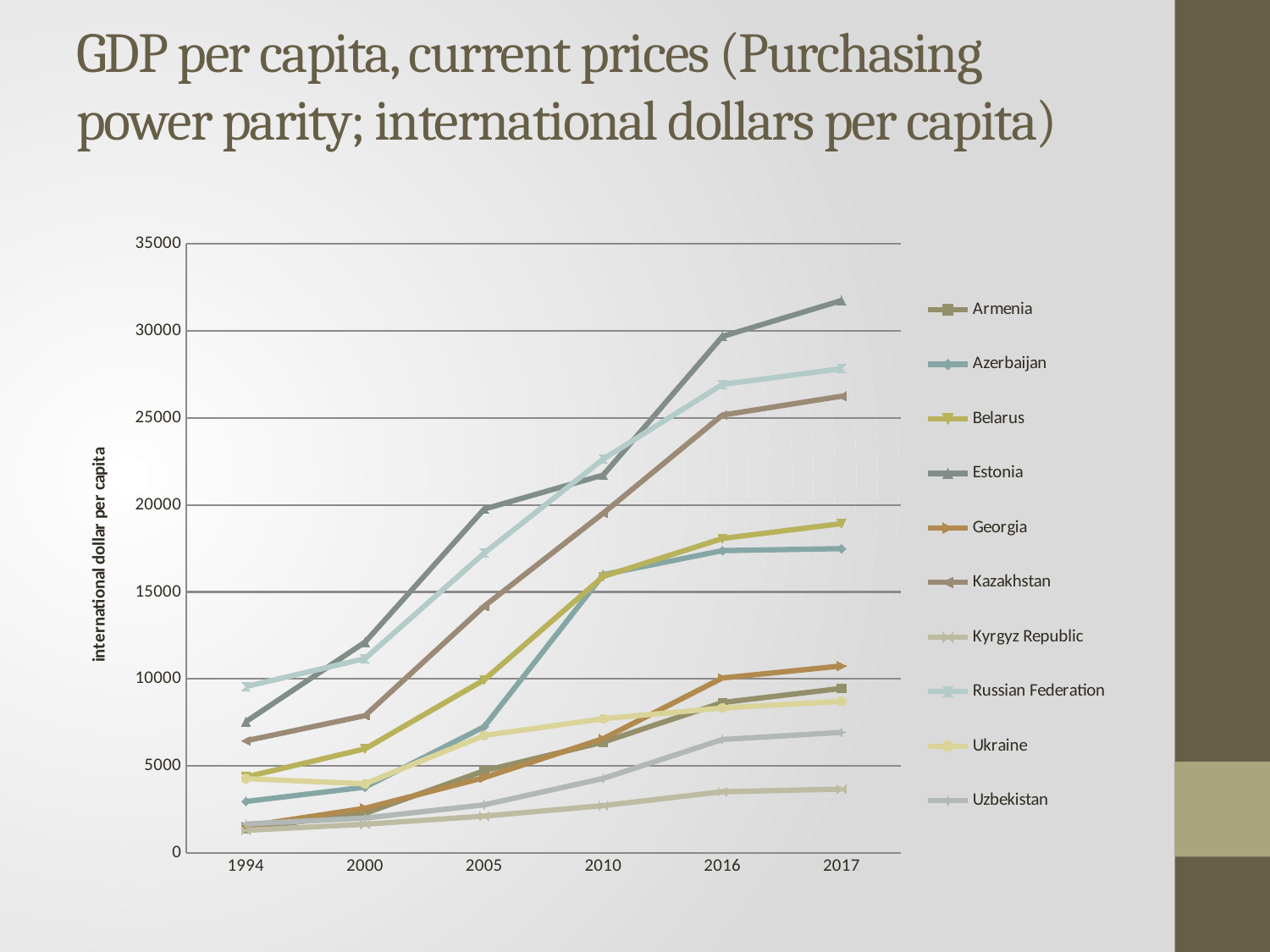
In 2017, which is larger: the value for Georgia or the value for Ukraine? Georgia Is the value for Estonia in 2017 greater or less than 30000? greater Does the value for Estonia rise or fall from 1994 to 2017? rise In 2017, which is larger: the value for Kazakhstan or the value for Belarus? Kazakhstan Is the value for the Kyrgyz Republic in 2017 greater or less than 5000? less What kind of chart is shown on the slide? line chart How many series does the legend list? 10 Which country has the highest GDP per capita in 1994? Russian Federation Is the value for the Russian Federation in 2016 greater or less than 25000? greater Which country has the highest GDP per capita in 2017? Estonia How many years are shown on the x axis? 6 Which country has the lowest GDP per capita in 2017? Kyrgyz Republic